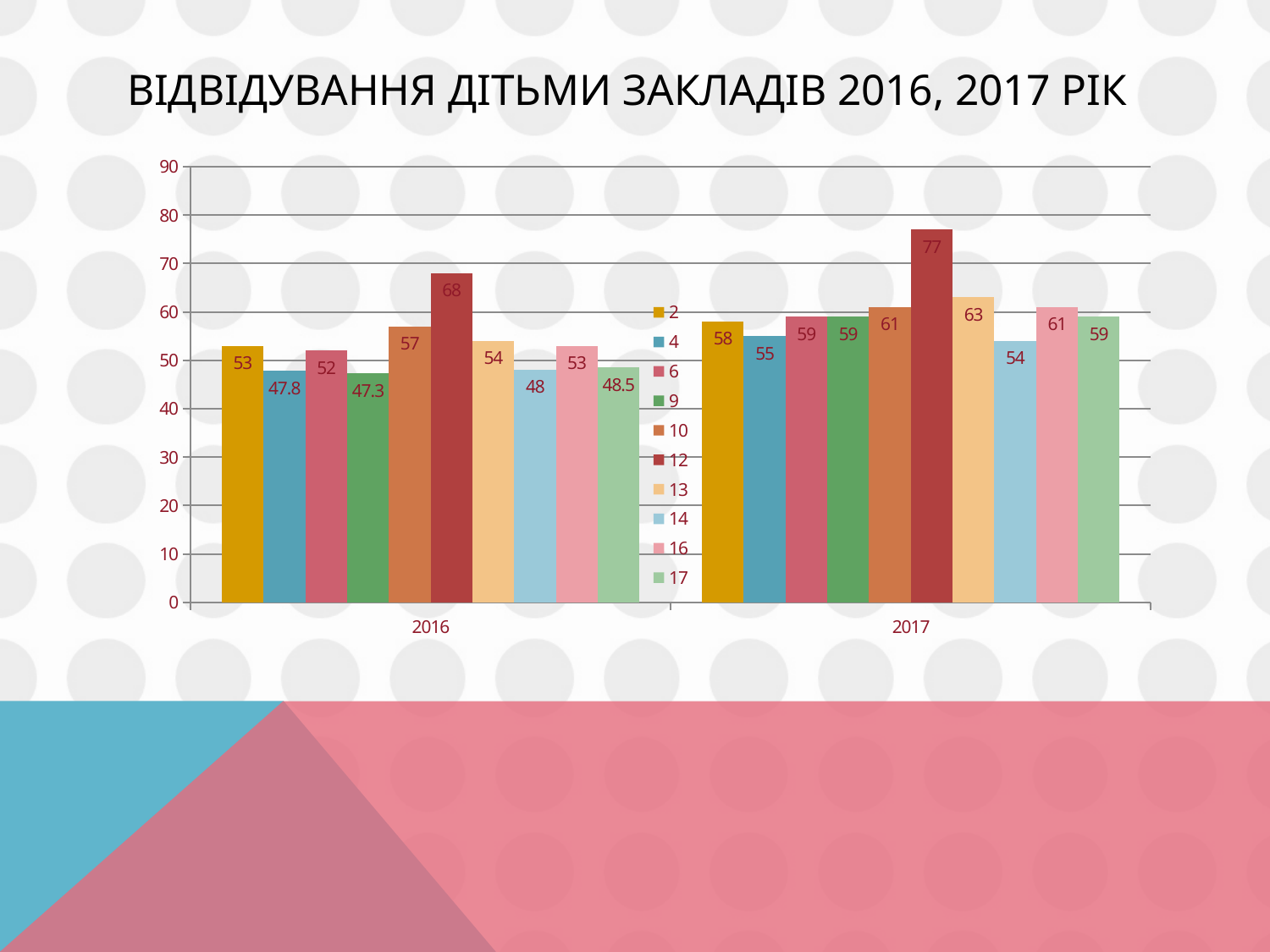
Which series has the lowest value in 2016? 9 How many series does the legend list? 10 Which series has the highest value in 2017? 12 What is the value for series 13 in 2017? 63 What type of chart is shown on the slide? bar chart Which is larger: the value for series 10 in 2016 or the value for series 13 in 2016? series 10 in 2016 How many categories are shown on the x axis? 2 Does the value for series 2 rise or fall from 2016 to 2017? rise What is the value for series 12 in 2016? 68 What is the value for series 4 in 2016? 47.8 Is the value for series 14 in 2017 greater or less than 50? greater What is the difference between the value for series 12 in 2017 and in 2016? 9